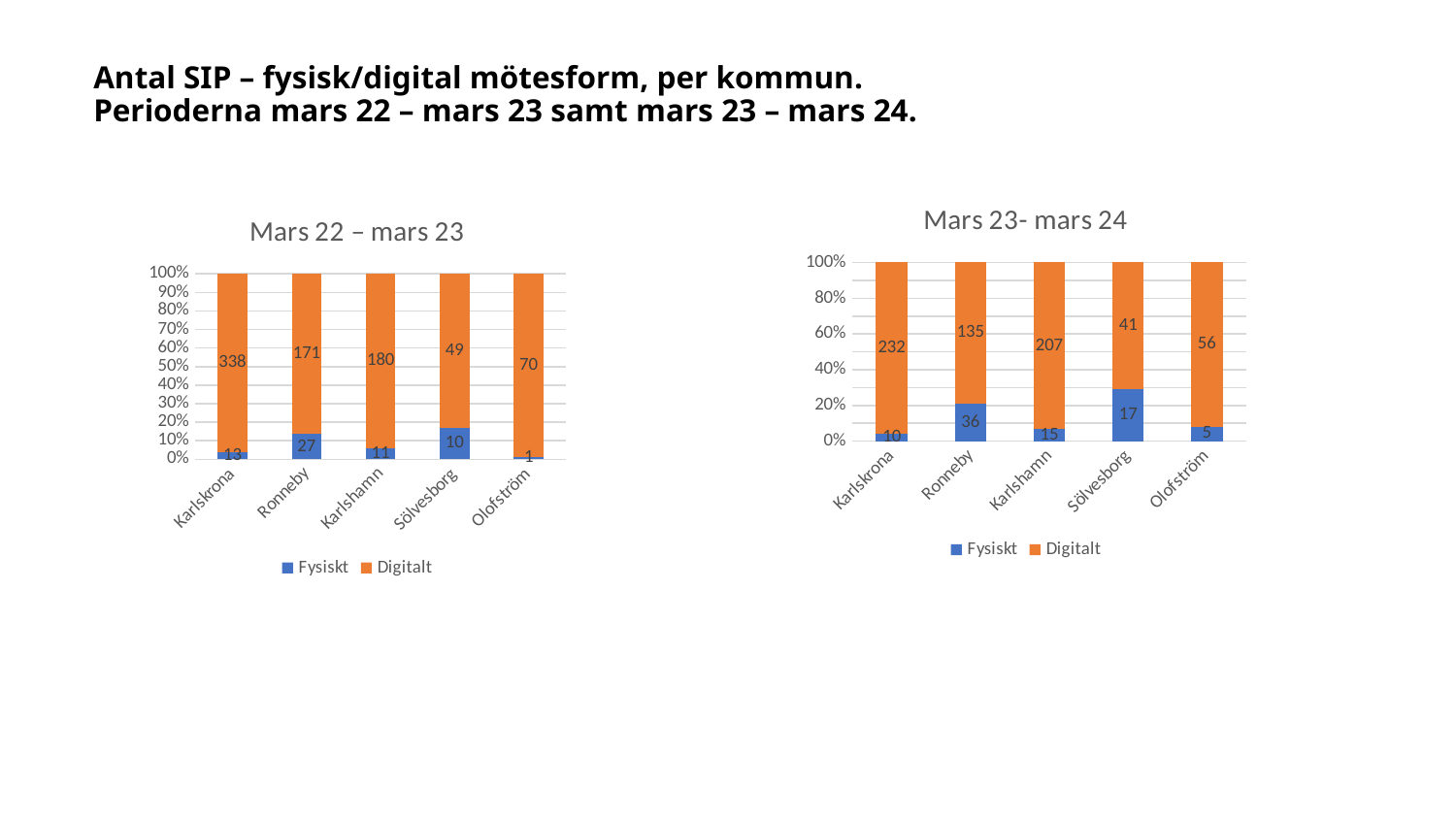
In the 'Mars 22 – mars 23' chart, which municipality has the lowest Fysiskt value? Olofström How many municipalities are shown on the x axis of the 'Mars 22 – mars 23' chart? 5 What kind of chart is the 'Mars 22 – mars 23' chart? Stacked bar chart In the 'Mars 23- mars 24' chart, what is the difference between the Digitalt values for Karlskrona and Karlshamn? 25 In the 'Mars 23- mars 24' chart, what is the Fysiskt value for Ronneby? 36 In the 'Mars 23- mars 24' chart, is the Fysiskt share of the Sölvesborg bar greater or less than 20%? greater In the 'Mars 22 – mars 23' chart, which municipality has the highest Digitalt value? Karlskrona In the 'Mars 23- mars 24' chart, what is the Digitalt value for Karlshamn? 207 In the 'Mars 22 – mars 23' chart, what is the Digitalt value for Karlskrona? 338 How many series does the legend of the 'Mars 23- mars 24' chart list? 2 In the 'Mars 23- mars 24' chart, which is larger, the Fysiskt value for Sölvesborg or for Karlshamn? Sölvesborg In the 'Mars 22 – mars 23' chart, what is the total of the Fysiskt and Digitalt values for Karlskrona? 351